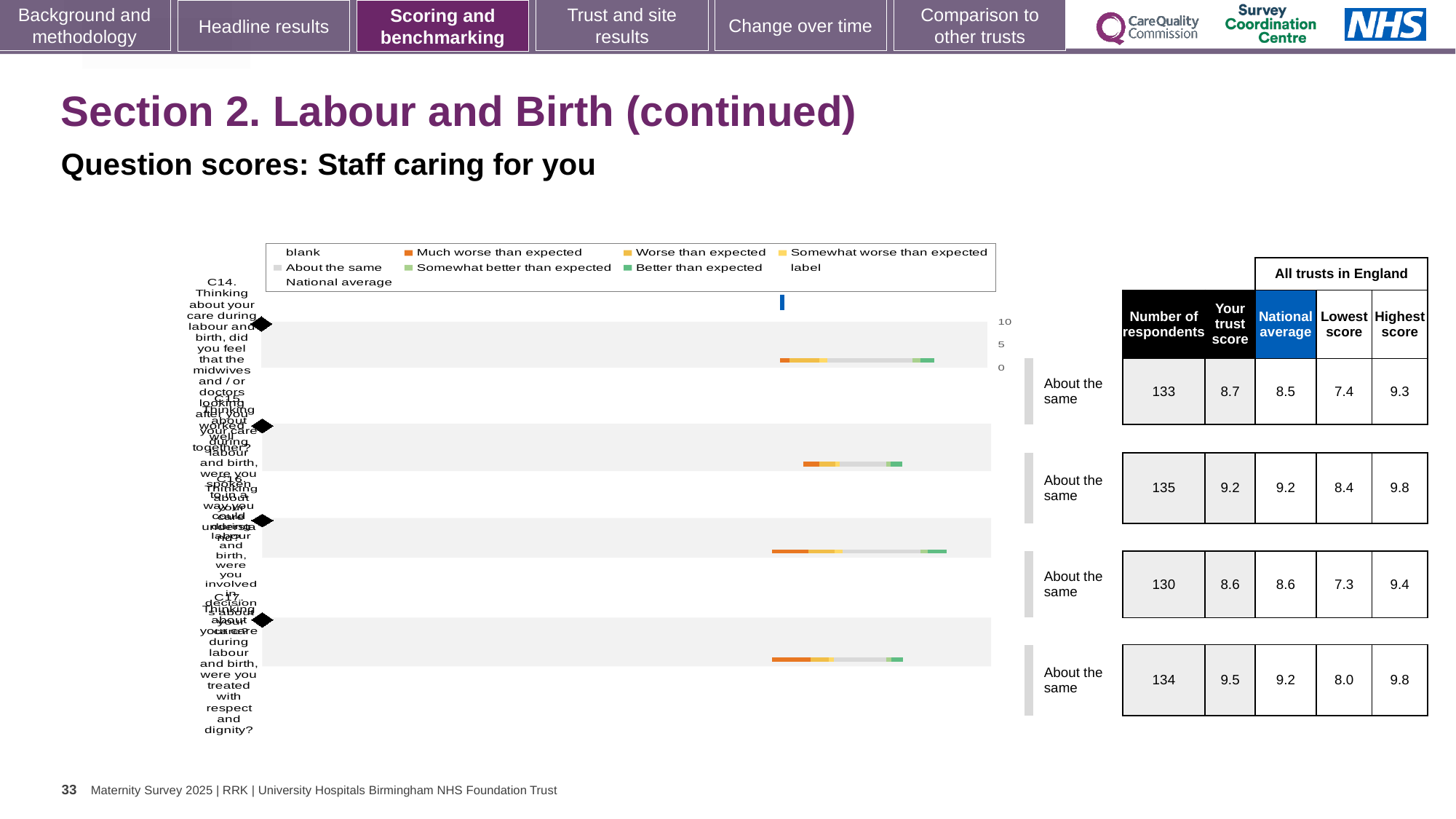
In the table beside the chart, which row has the lowest 'Lowest score' across all trusts in England? the third row (C16), 7.3 What kind of chart is shown on the slide? bar chart How many entries does the chart legend list? 9 How many question rows (bars) are plotted in the chart? 4 In the table beside the chart, which row has the highest 'Your trust score'? the fourth row (C17), 9.5 In the table beside the chart, is the trust score for the first row (C14) higher or lower than the national average? higher In the table beside the chart, what is the highest score across all trusts in England for the second row (C15)? 9.8 In the table beside the chart, what is the 'Your trust score' for the first row (C14)? 8.7 What colour does the legend use for 'Much worse than expected'? orange What benchmark category is shown for each of the four questions in the chart? About the same In the table beside the chart, what is the difference between the trust score and the national average for the fourth row (C17)? 0.3 In the table beside the chart, what is the number of respondents for the fourth row (C17, treated with respect and dignity)? 134